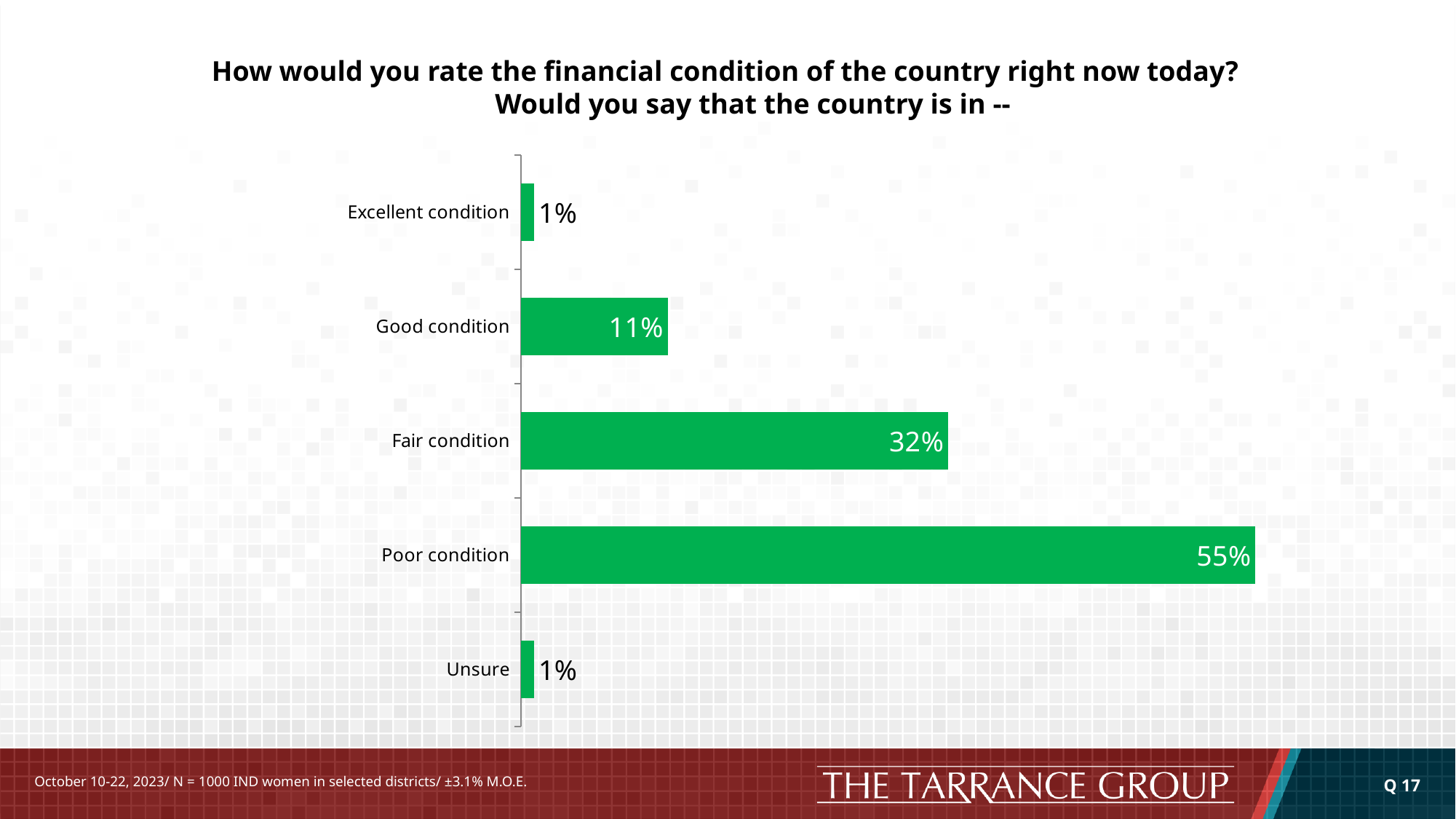
Which response category has the highest value? Poor condition What is the difference between the Poor condition and Fair condition values? 23% What percentage of respondents were unsure? 1% Which is larger, the value for Good condition or the value for Fair condition? Fair condition What percentage of respondents said the country is in good condition? 11% What kind of chart is shown on the slide? Bar chart What percentage of respondents said the country is in excellent condition? 1% What colour are the bars in the chart? Green What percentage of respondents said the country is in fair condition? 32% What percentage of respondents said the country is in poor condition? 55% How many response categories are shown in the chart? 5 What is the difference between the Fair condition and Good condition values? 21%